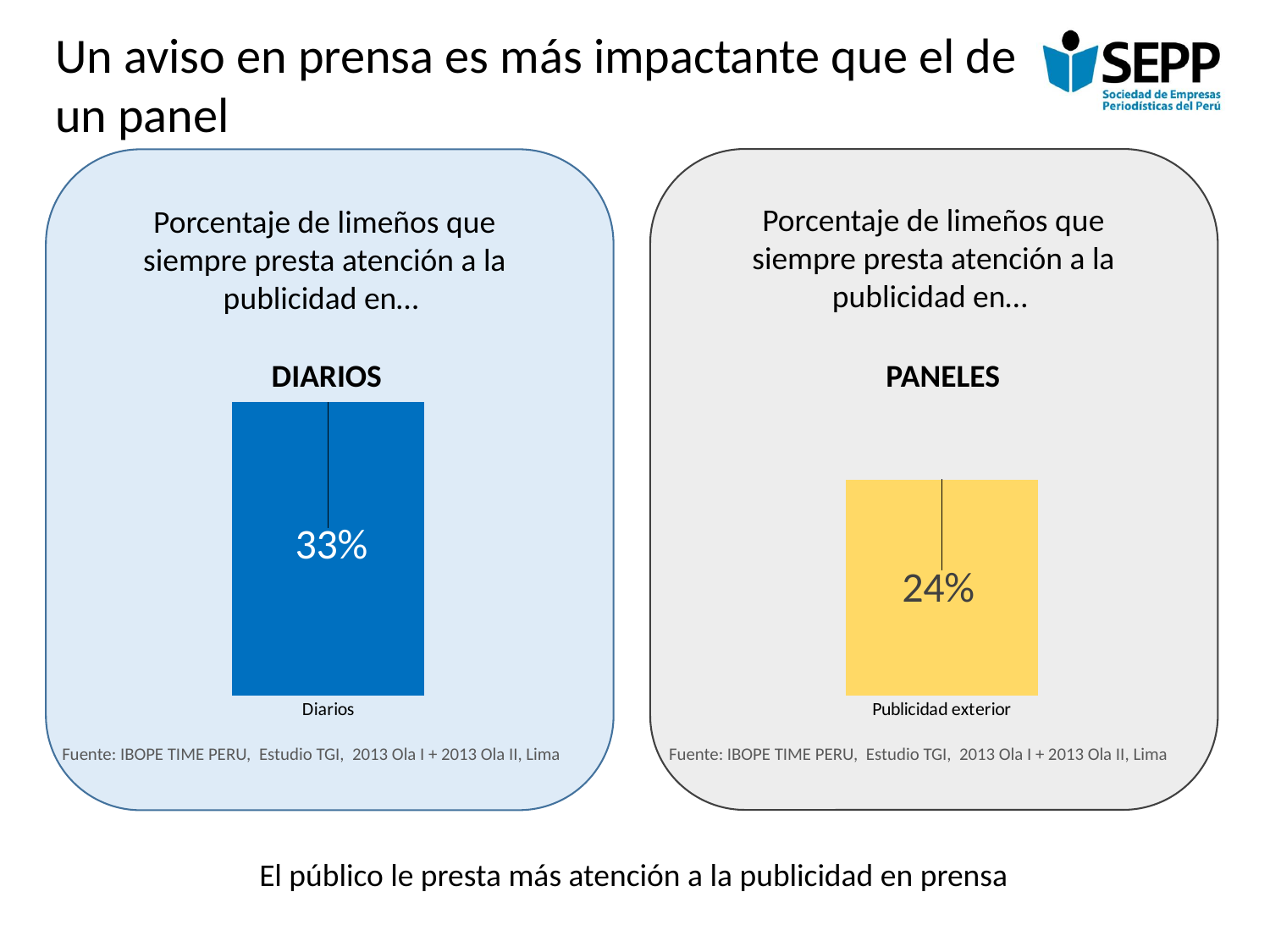
What colour is the bar in the PANELES chart on the right? Yellow What is the category label under the bar in the PANELES chart on the right? Publicidad exterior What is the difference between the Diarios value in the left chart and the Publicidad exterior value in the right chart? 9% In the PANELES chart on the right, what is the value shown for Publicidad exterior? 24% How many bars does the PANELES chart on the right show? 1 Which is larger: the value for Diarios in the left chart or the value for Publicidad exterior in the right chart? Diarios What kind of chart is the DIARIOS chart on the left? Bar chart What kind of chart is the PANELES chart on the right? Bar chart In the DIARIOS chart on the left, what is the value shown for Diarios? 33% How many bars does the DIARIOS chart on the left show? 1